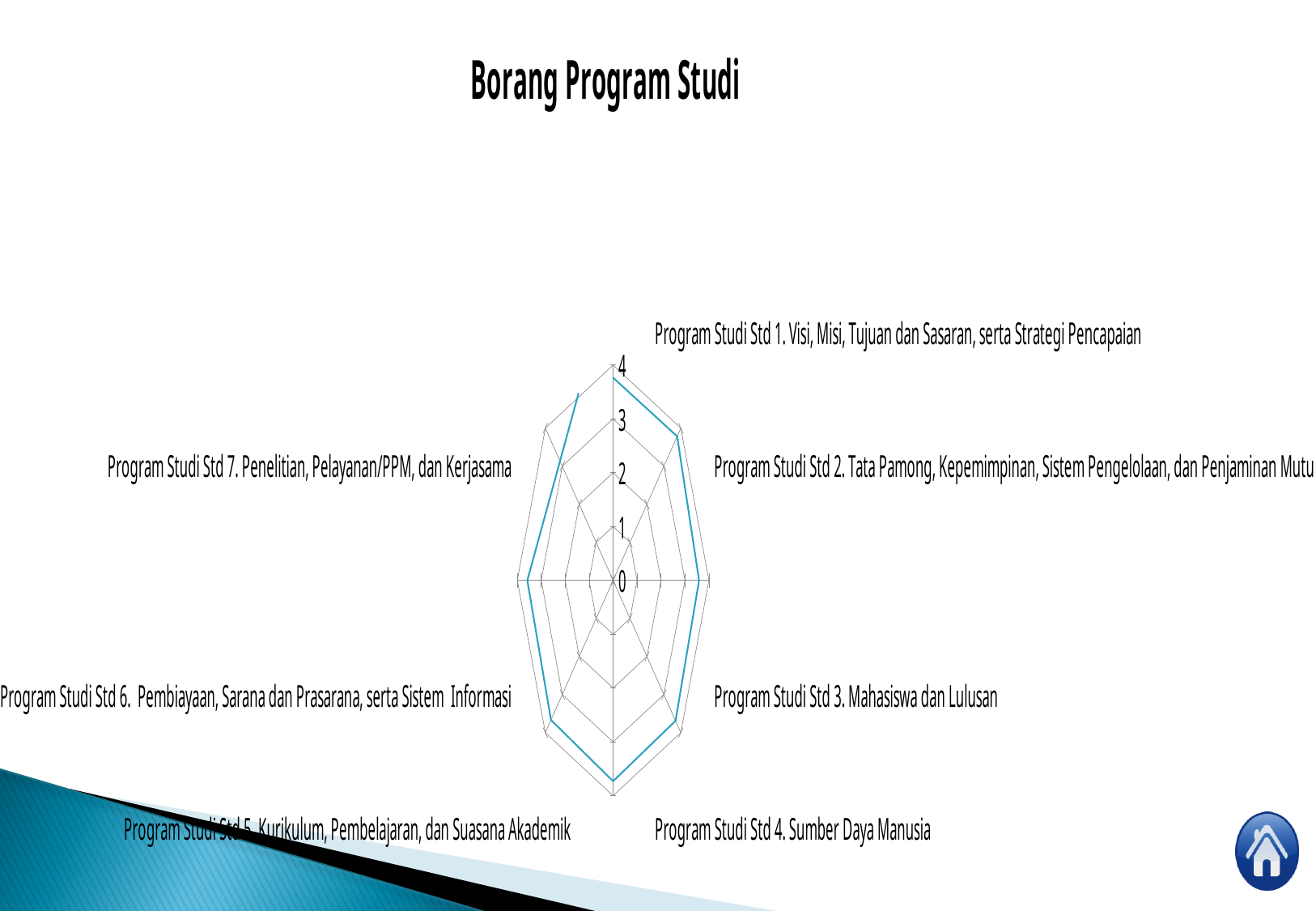
Is the value for Program Studi Std 7. Penelitian, Pelayanan/PPM, dan Kerjasama greater or less than 3? greater Is the value for Program Studi Std 1. Visi, Misi, Tujuan dan Sasaran, serta Strategi Pencapaian greater or less than 3? greater Is the value for Program Studi Std 4. Sumber Daya Manusia greater or less than 2? greater What is the lowest value marked on the radar chart's axis scale? 0 How many categories (axes) does the radar chart have? 7 What is the title of the chart on the slide? Borang Program Studi What is the maximum value shown on the radar chart's axis scale? 4 What kind of chart is shown on the slide? radar chart